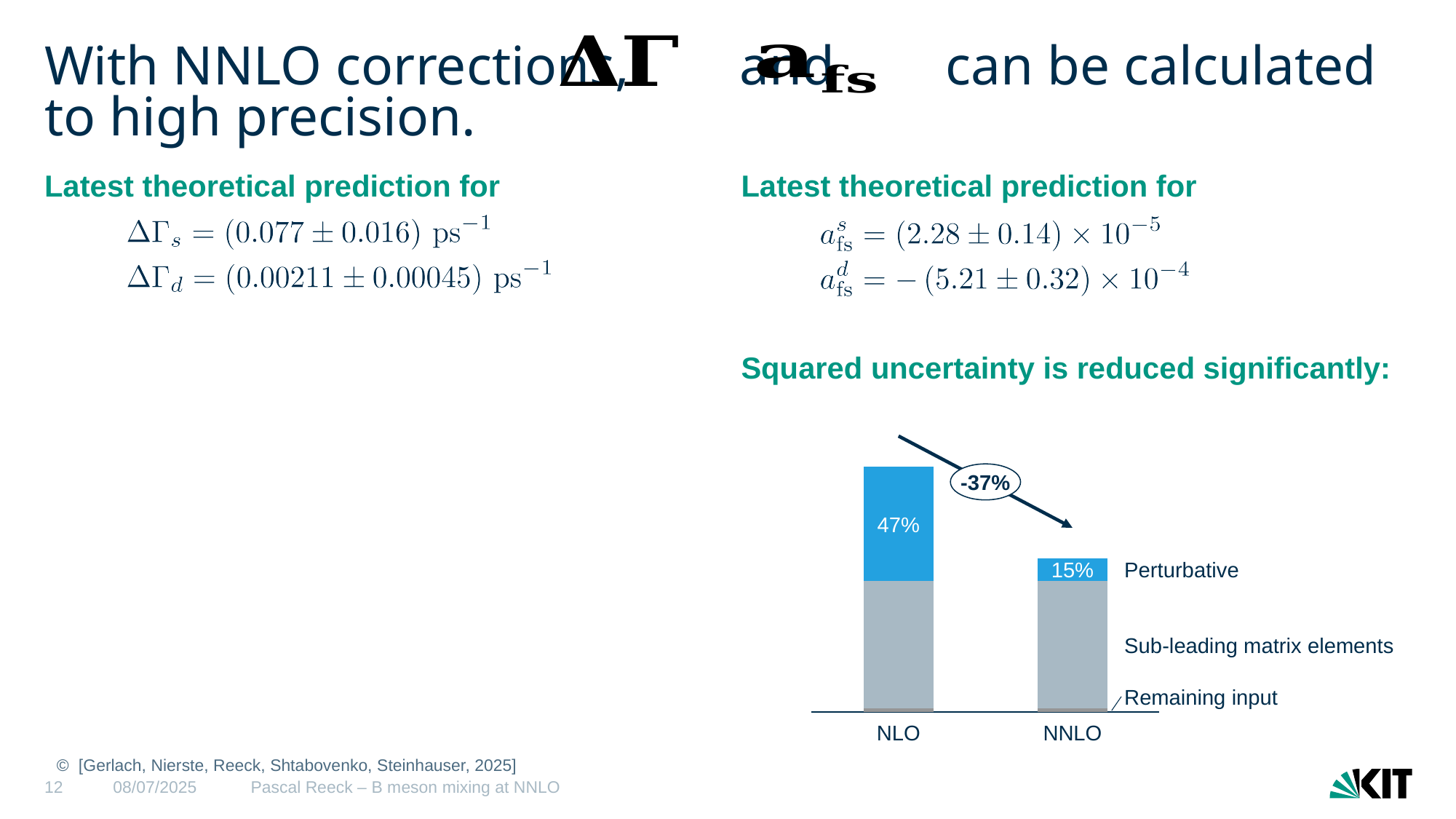
How many series (stacked components) are labelled in the chart? 3 Which category has the taller total bar in the chart? NLO Which category has the shorter total bar in the chart? NNLO By how many percentage points does the Perturbative share drop from NLO to NNLO? 32 What is the Perturbative share shown for NLO in the squared uncertainty chart? 47% Which series is drawn in blue in the chart? Perturbative Does the total squared uncertainty rise or fall from NLO to NNLO? Fall What kind of chart is used to show the squared uncertainty? Stacked bar chart Which bar has the larger Perturbative share, NLO or NNLO? NLO What percentage change is written in the oval annotation above the bars? -37% How many categories are shown on the x axis of the chart? 2 What is the Perturbative share shown for NNLO in the squared uncertainty chart? 15%